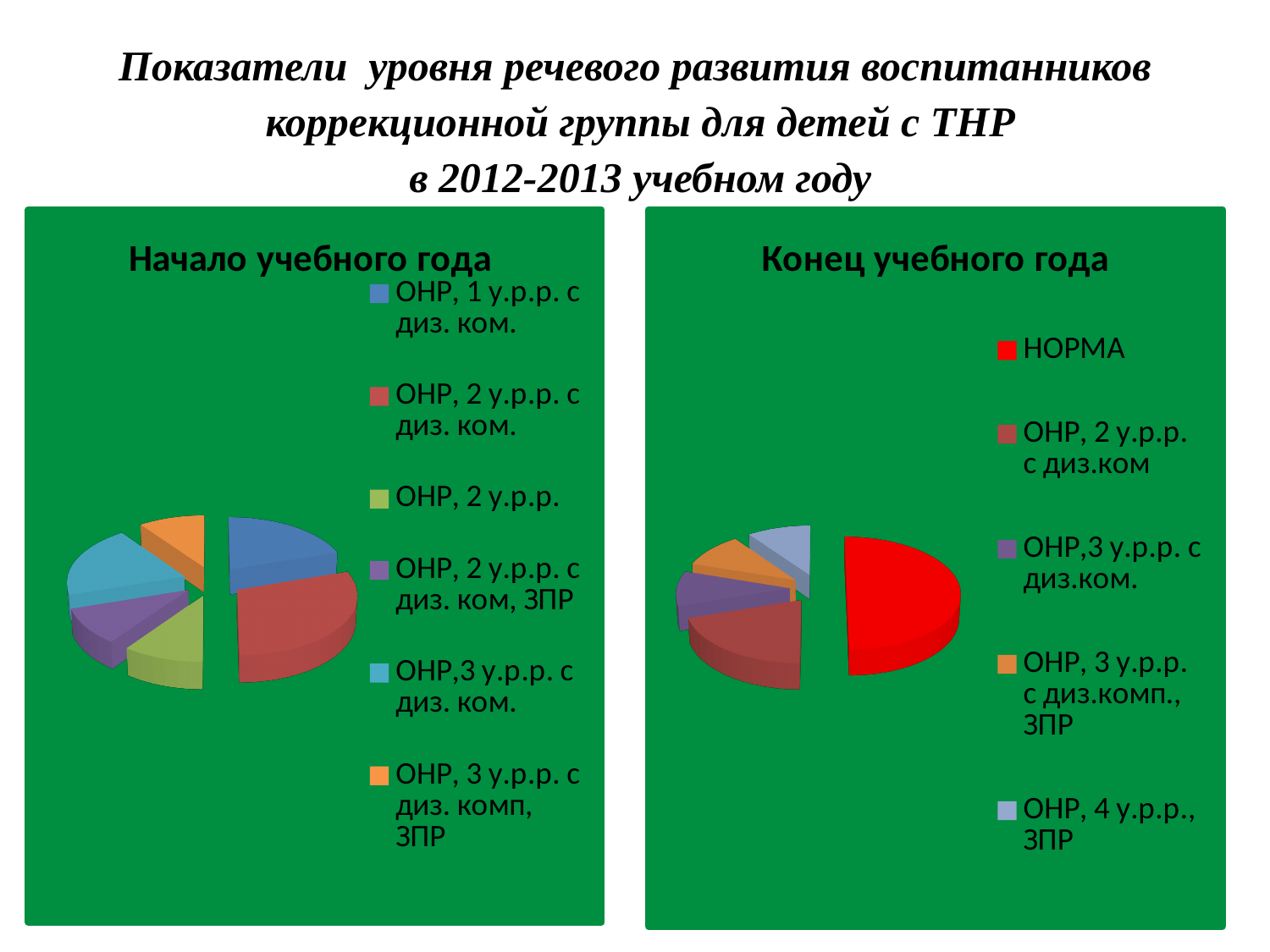
In the 'Начало учебного года' chart, which slice is larger: ОНР, 2 у.р.р. с диз. ком. or ОНР, 2 у.р.р.? ОНР, 2 у.р.р. с диз. ком. What kind of chart is the 'Конец учебного года' chart? pie chart How many entries does the legend of the 'Конец учебного года' chart list? 5 How many slices does the 'Начало учебного года' pie chart have? 6 In the 'Конец учебного года' chart, which category has the largest slice? НОРМА How many entries does the legend of the 'Начало учебного года' chart list? 6 What kind of chart is the 'Начало учебного года' chart? pie chart How many slices does the 'Конец учебного года' pie chart have? 5 In the 'Начало учебного года' chart, which category has the largest slice? ОНР, 2 у.р.р. с диз. ком. In the 'Конец учебного года' chart, what colour is the НОРМА slice? red In the 'Конец учебного года' chart, which slice is larger: НОРМА or ОНР, 2 у.р.р. с диз.ком? НОРМА What is the title of the pie chart on the left side of the slide? Начало учебного года